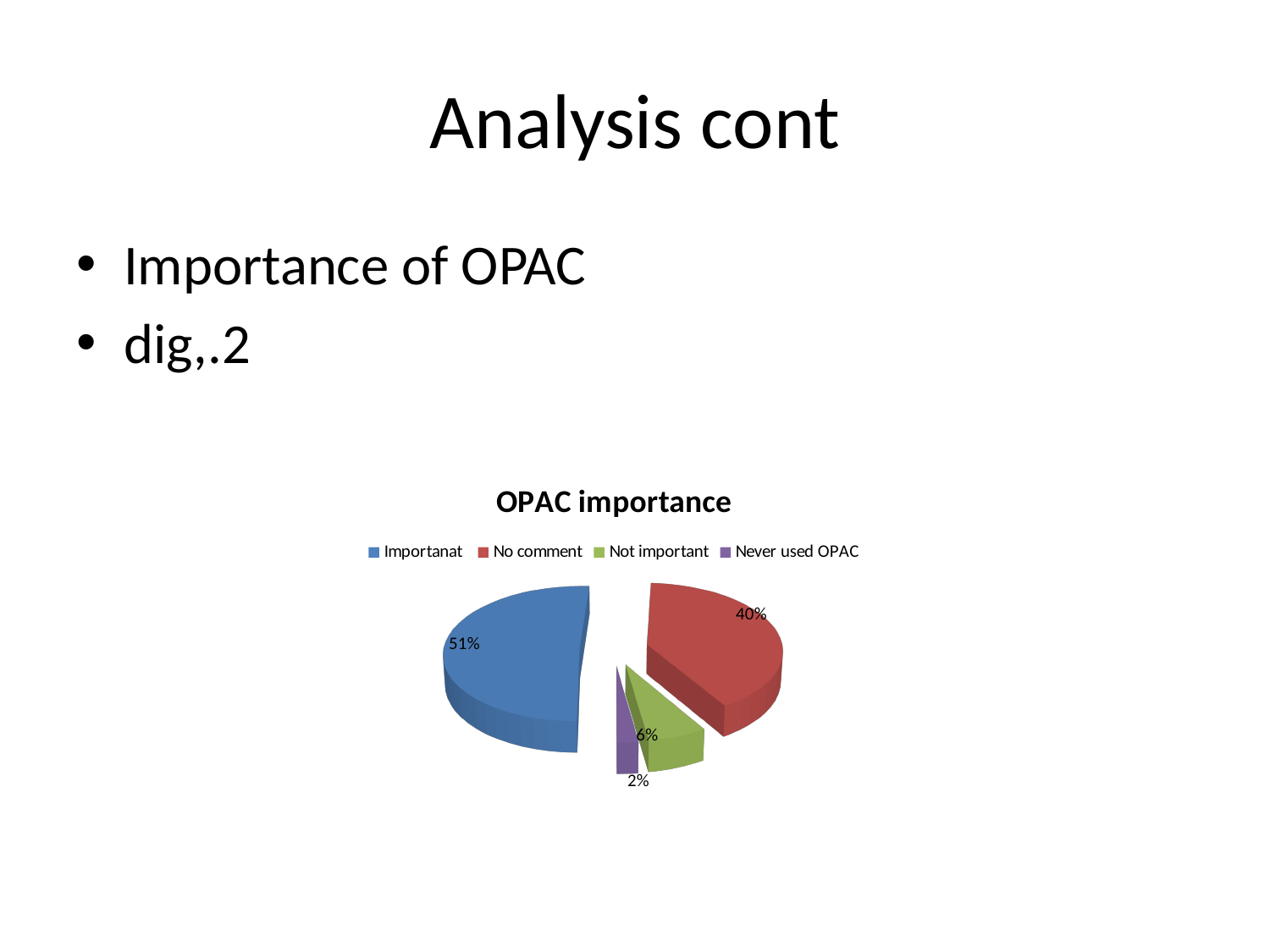
What percentage of the pie is labelled for Never used OPAC? 2% Which slice is larger, Not important or Never used OPAC? Not important What kind of chart is shown on the slide? Pie chart What percentage of the pie is labelled for Not important? 6% Which category has the largest slice of the pie? Importanat What percentage of the pie is labelled for Importanat? 51% What is the title of the chart? OPAC importance What is the difference in percentage points between the Importanat and No comment slices? 11 What percentage of the pie is labelled for No comment? 40% What colour is the slice for No comment? Red How many categories does the legend list? 4 Which category has the smallest slice of the pie? Never used OPAC